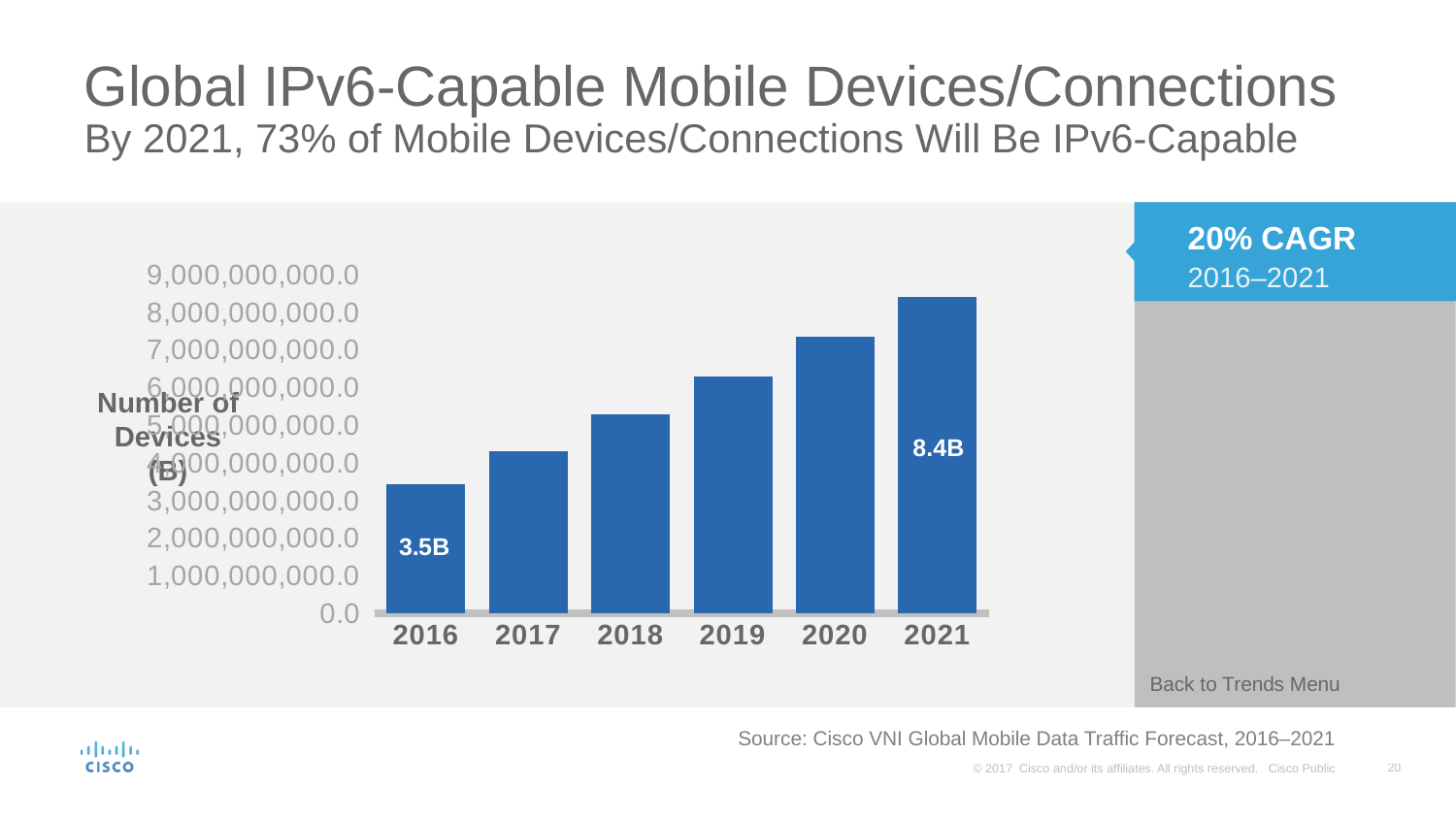
Which year has the highest number of IPv6-capable devices? 2021 Which year has the lowest number of IPv6-capable devices? 2016 How many years are shown on the x axis? 6 Is the value for 2020 greater or less than 6,000,000,000.0? greater What is the value for 2021? 8.4B Is the value for 2017 greater or less than 5,000,000,000.0? less What is the difference between the values for 2021 and 2016? 4.9B What kind of chart is shown on the slide? bar chart Do the values rise or fall from 2016 to 2021? rise Which is larger, the value for 2020 or the value for 2018? 2020 Is the value for 2018 greater or less than 4,000,000,000.0? greater What is the value for 2016? 3.5B